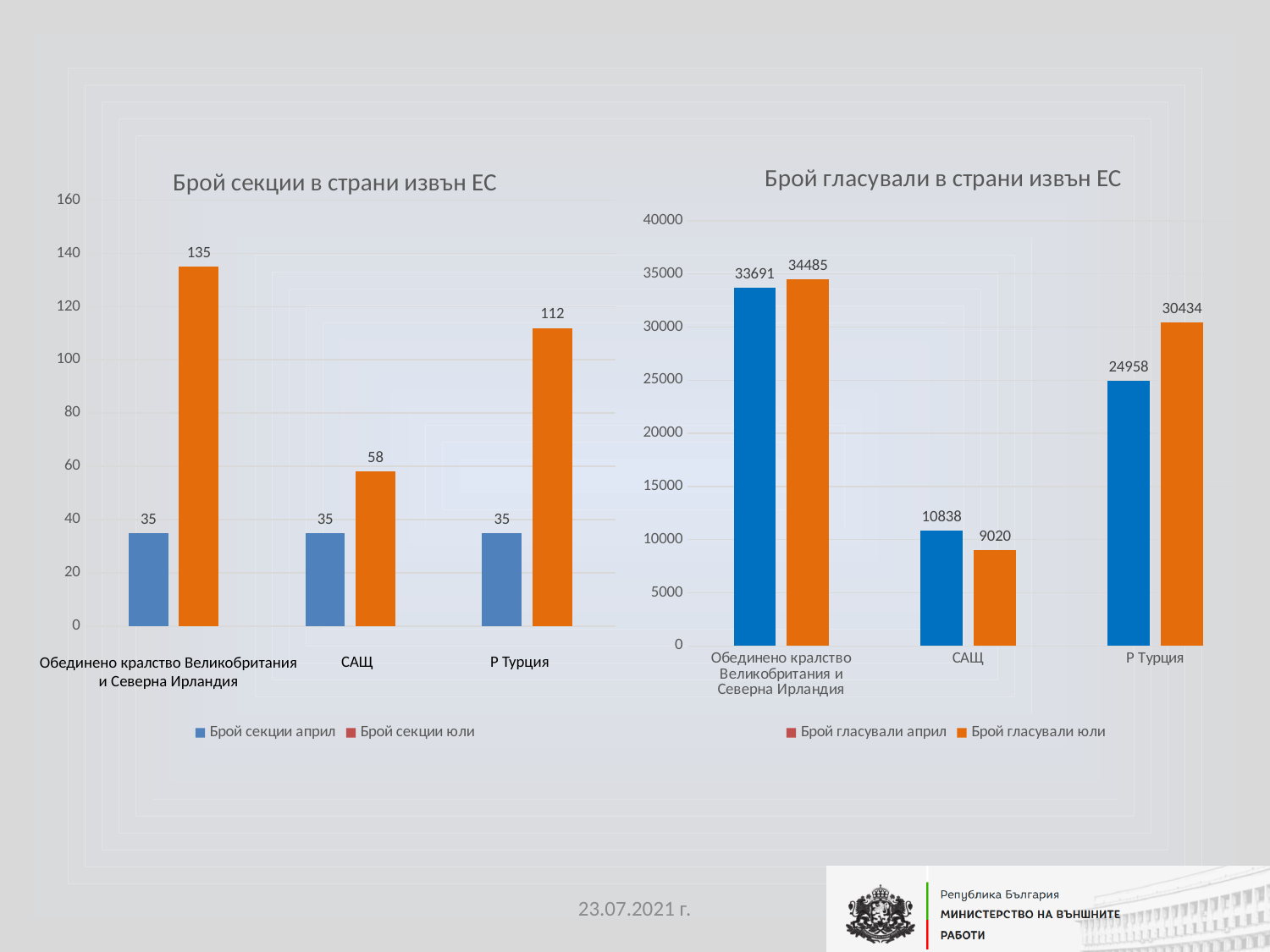
In the chart titled "Брой гласували в страни извън ЕС", what is the difference between "Брой гласували юли" and "Брой гласували април" for Р Турция? 5476 In the chart titled "Брой секции в страни извън ЕС", which category has the highest value for "Брой секции юли"? Обединено кралство Великобритания и Северна Ирландия In the chart titled "Брой гласували в страни извън ЕС", which category has the lowest value for "Брой гласували юли"? САЩ In the chart titled "Брой секции в страни извън ЕС", how many series does the legend list? 2 What kind of chart is the chart titled "Брой секции в страни извън ЕС"? Bar chart In the chart titled "Брой секции в страни извън ЕС", what is the value of "Брой секции юли" for САЩ? 58 In the chart titled "Брой гласували в страни извън ЕС", what is the value of "Брой гласували април" for САЩ? 10838 In the chart titled "Брой гласували в страни извън ЕС", which is larger for САЩ: "Брой гласували април" or "Брой гласували юли"? Брой гласували април How many categories are shown on the x axis of the chart titled "Брой гласували в страни извън ЕС"? 3 In the chart titled "Брой секции в страни извън ЕС", what is the difference between "Брой секции юли" and "Брой секции април" for Р Турция? 77 In the chart titled "Брой гласували в страни извън ЕС", what is the value of "Брой гласували юли" for Р Турция? 30434 In the chart titled "Брой секции в страни извън ЕС", what is the value of "Брой секции април" for Р Турция? 35